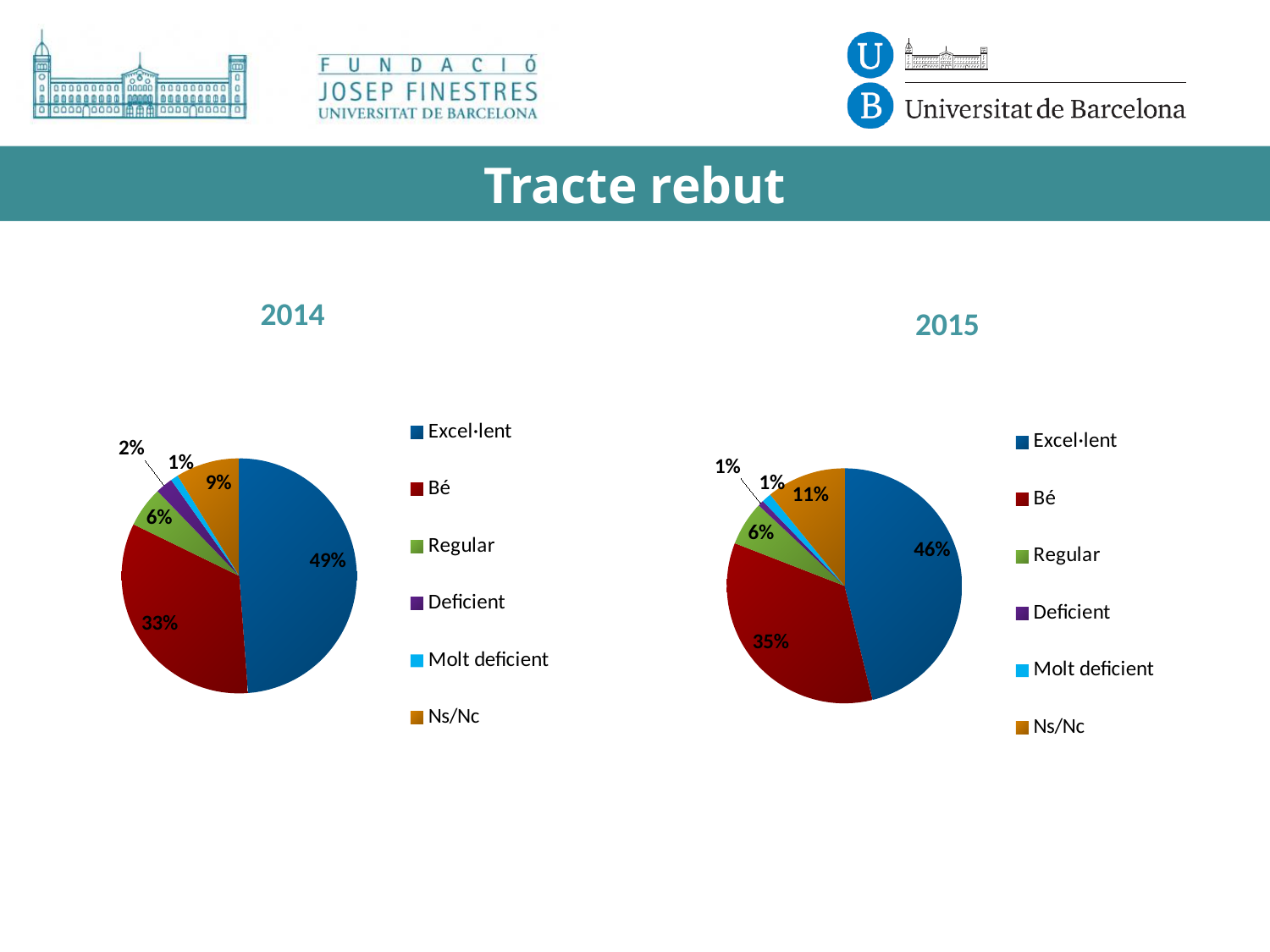
In the 2015 chart, what is the difference between the Excel·lent and Bé shares? 11% In the 2014 chart, what is the difference between the Excel·lent and Bé shares? 16% What type of chart is used for the 2015 data? Pie chart Which chart shows a larger share for Ns/Nc, 2014 or 2015? 2015 In the 2015 chart, what share does Bé have? 35% How many categories does the legend of the 2014 chart list? 6 In the 2014 chart, what share does Regular have? 6% In the 2015 chart, which category has the largest slice? Excel·lent What is the title of the slide? Tracte rebut In the 2014 chart, what share does Excel·lent have? 49% In the 2014 chart, which category has the largest slice? Excel·lent In the 2015 chart, what share does Ns/Nc have? 11%